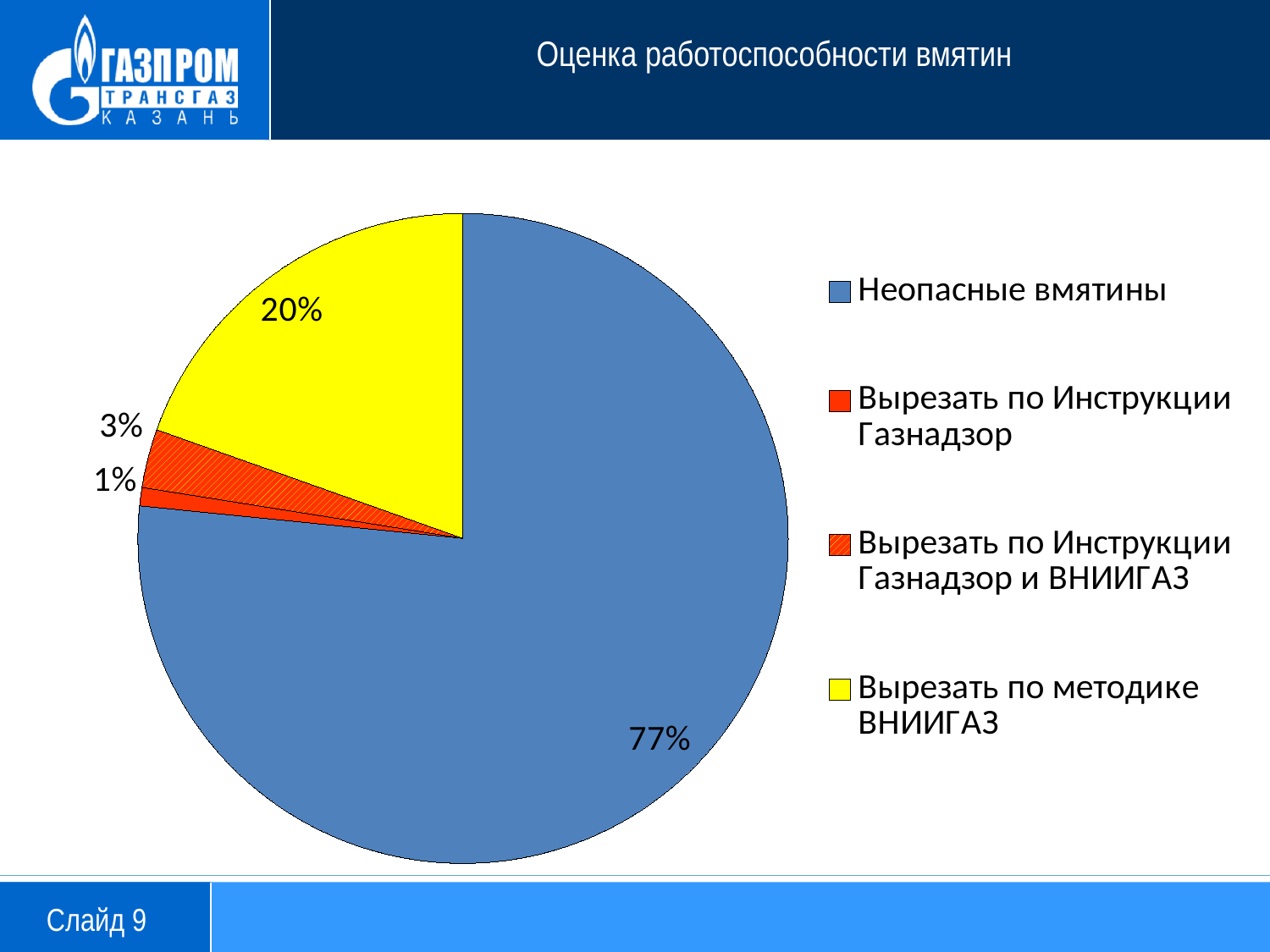
What share of the pie does "Вырезать по Инструкции Газнадзор" represent? 1% What share of the pie does "Вырезать по Инструкции Газнадзор и ВНИИГАЗ" represent? 3% What is the difference in percentage points between "Неопасные вмятины" and "Вырезать по методике ВНИИГАЗ"? 57 What colour is the slice for "Вырезать по методике ВНИИГАЗ"? Yellow Which category has the smallest slice of the pie? Вырезать по Инструкции Газнадзор Which is larger: the slice for "Вырезать по Инструкции Газнадзор и ВНИИГАЗ" or the slice for "Вырезать по Инструкции Газнадзор"? Вырезать по Инструкции Газнадзор и ВНИИГАЗ What is the title of the slide containing the chart? Оценка работоспособности вмятин What share of the pie does "Неопасные вмятины" represent? 77% Which category has the largest slice of the pie? Неопасные вмятины What kind of chart is shown on the slide? Pie chart What share of the pie does "Вырезать по методике ВНИИГАЗ" represent? 20% How many categories does the pie chart show? 4